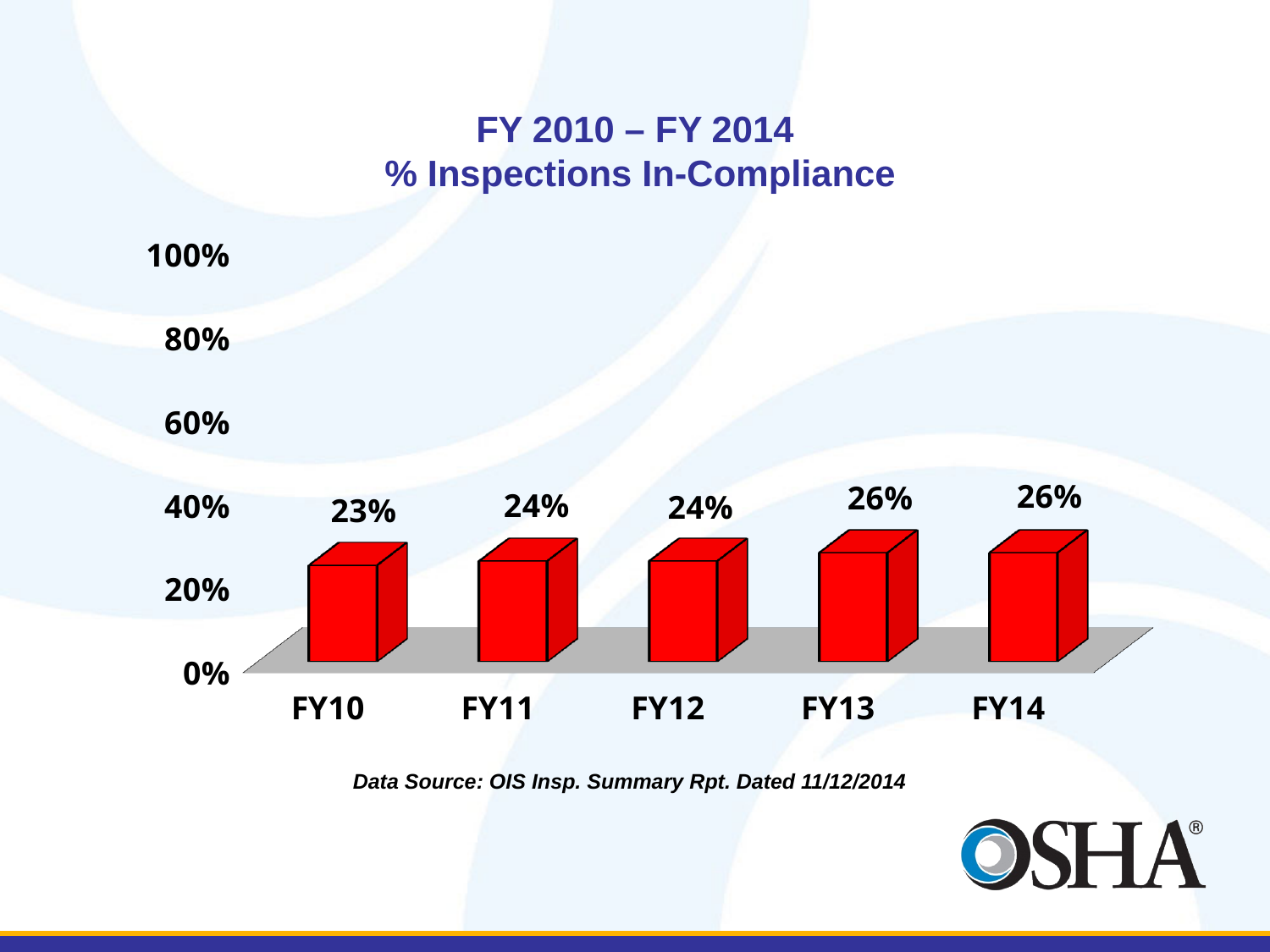
What is the difference in % inspections in-compliance between FY14 and FY10? 3% What is the % inspections in-compliance for FY10? 23% How many fiscal years are shown on the x axis? 5 What is the difference in % inspections in-compliance between FY13 and FY11? 2% Is the value for FY12 greater or less than 40%? less Which is larger, the value for FY11 or the value for FY13? FY13 What kind of chart is shown on the slide? bar chart Do the values generally rise or fall from FY10 to FY14? rise What is the % inspections in-compliance for FY14? 26% What is the title of the chart? FY 2010 – FY 2014 % Inspections In-Compliance What is the % inspections in-compliance for FY12? 24% Which fiscal year has the lowest % inspections in-compliance? FY10